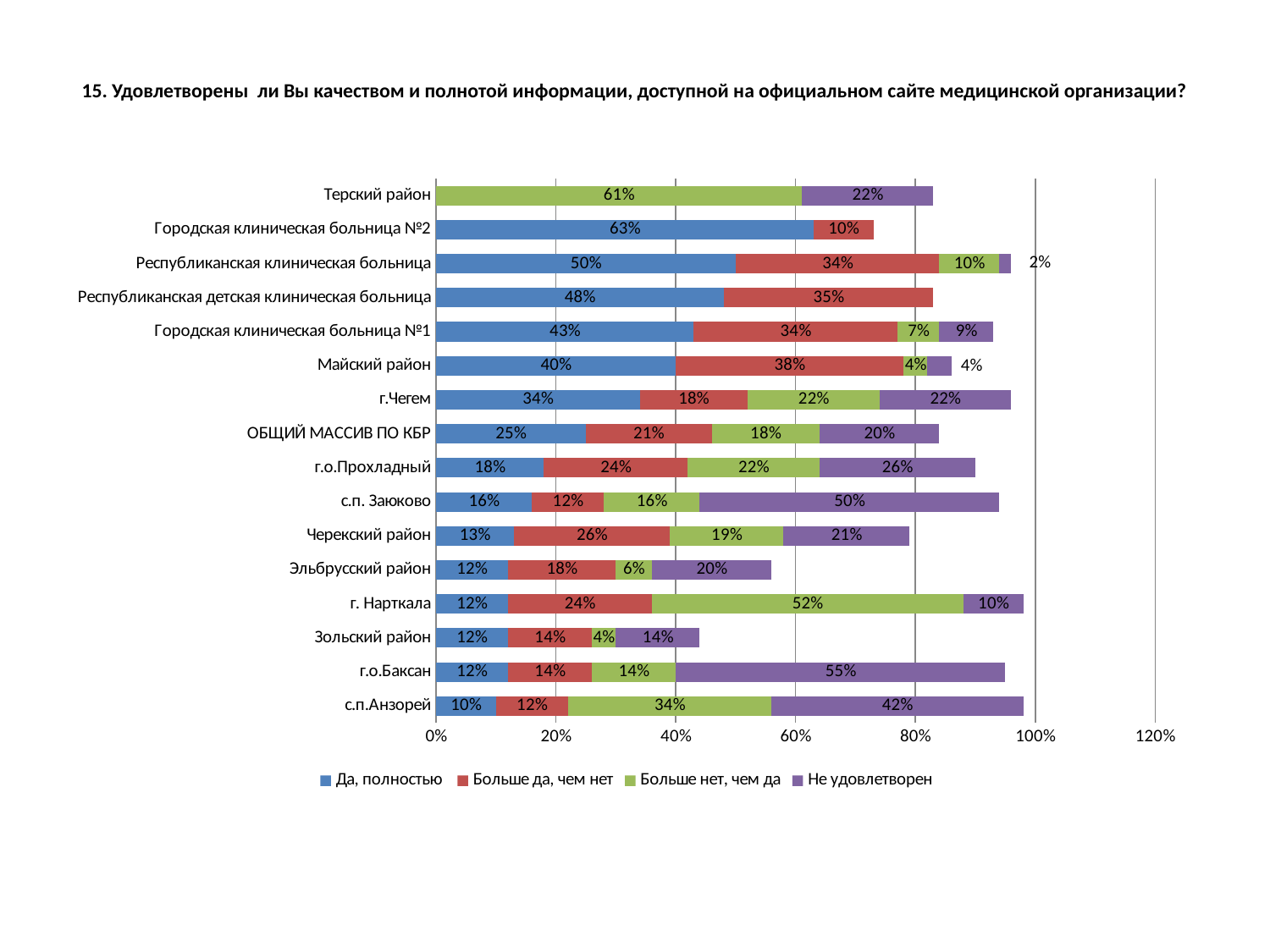
What is the difference between the "Не удовлетворен" values for г.о.Баксан and с.п. Заюково? 5% What is the value of "Больше нет, чем да" for г. Нарткала? 52% What kind of chart is shown on the slide? Stacked bar chart Which category has the lowest value for "Да, полностью"? с.п.Анзорей What is the value of "Больше да, чем нет" for ОБЩИЙ МАССИВ ПО КБР? 21% Which is larger: the "Больше нет, чем да" value for Терский район or for г. Нарткала? Терский район Which category has the highest value for "Да, полностью"? Городская клиническая больница №2 How many categories are shown on the chart? 16 What is the total of the stacked bar for г.Чегем? 96% What is the value of "Да, полностью" for Городская клиническая больница №2? 63% How many series does the legend list? 4 What is the value of "Не удовлетворен" for г.о.Баксан? 55%